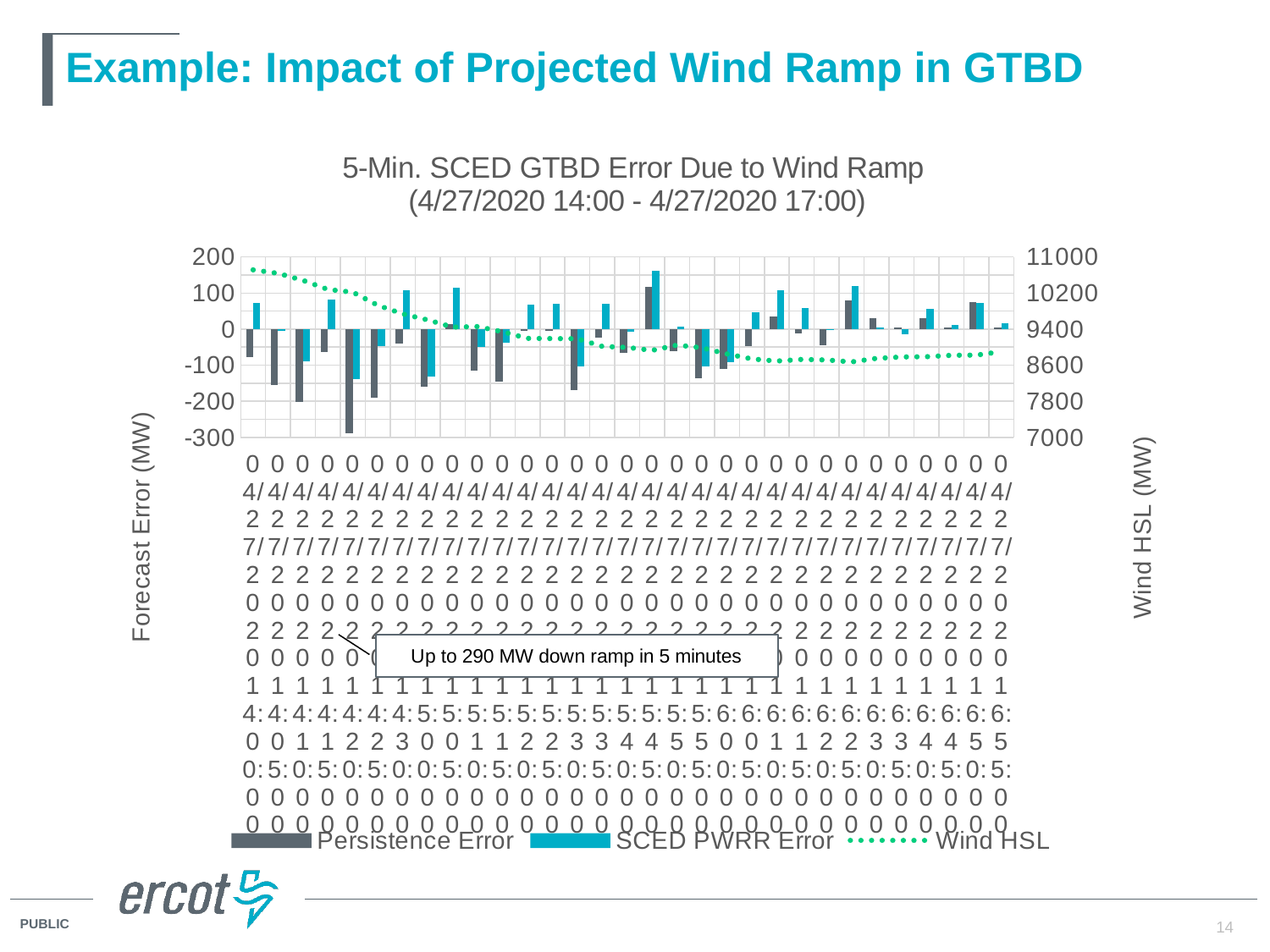
Is the lowest Persistence Error bar greater or less than -200? less Does the Wind HSL line generally rise or fall from left to right across the chart? Fall What is the minimum value shown on the right (Wind HSL) axis? 7000 Is the Wind HSL value at the start of the period (14:00) greater or less than 10200? greater How many series does the chart legend list? 3 Is the Wind HSL value at the end of the period greater or less than 9400? less According to the annotation on the chart, how large a down ramp occurred in 5 minutes? Up to 290 MW What is the title of the chart? 5-Min. SCED GTBD Error Due to Wind Ramp (4/27/2020 14:00 - 4/27/2020 17:00) What is the maximum value shown on the left (Forecast Error) axis? 200 What kind of chart is shown on the slide? A combined bar and line chart What are the three series listed in the chart legend? Persistence Error, SCED PWRR Error, Wind HSL